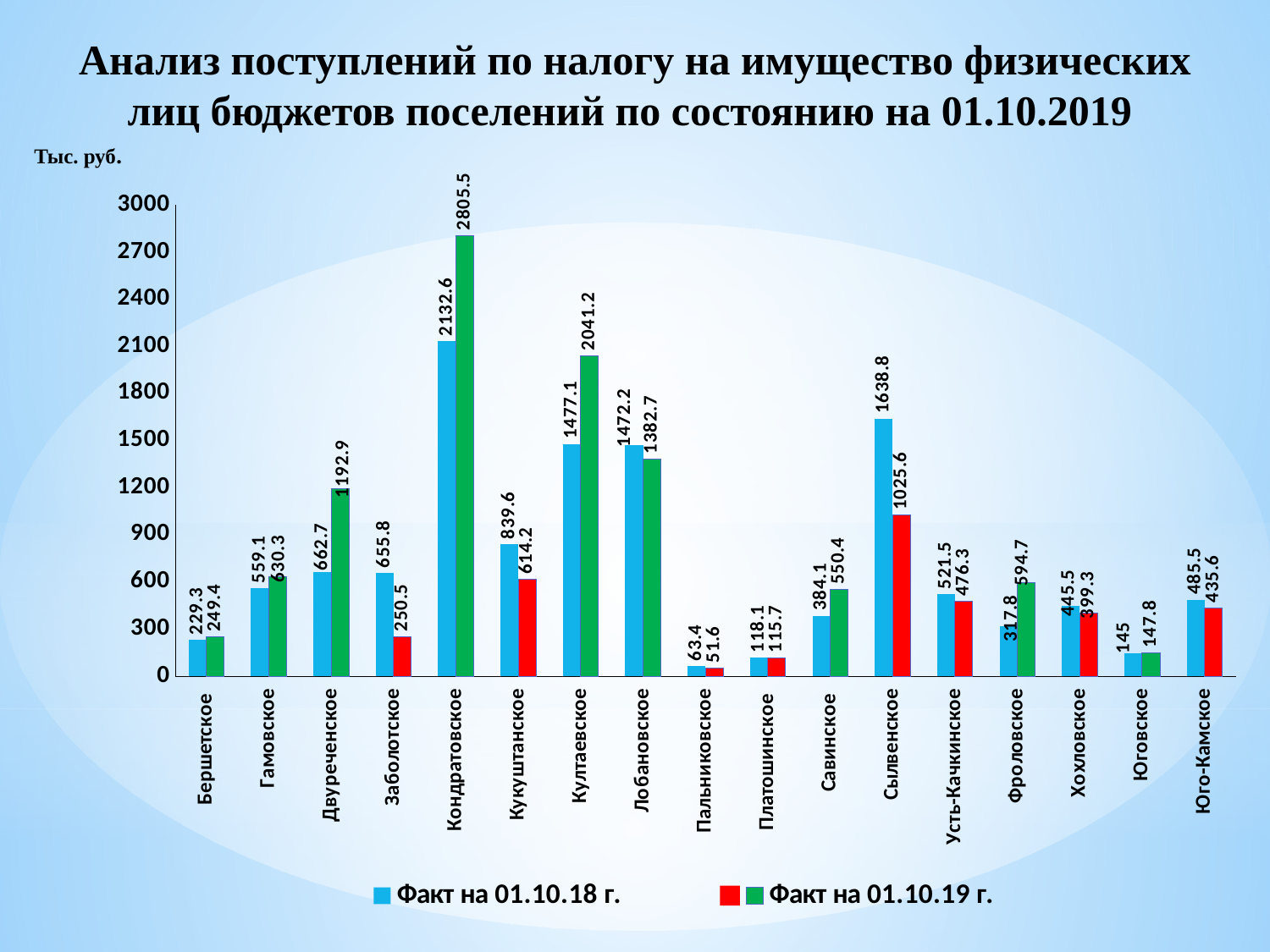
What is the value for Кондратовское in the series Факт на 01.10.19 г.? 2805.5 Which category has the lowest value in the series Факт на 01.10.18 г.? Пальниковское What is the difference between the Факт на 01.10.19 г. and Факт на 01.10.18 г. values for Кондратовское? 672.9 How many categories (settlements) are shown on the x axis? 17 Which is larger: the Факт на 01.10.18 г. value for Кукуштанское or the Факт на 01.10.18 г. value for Гамовское? Кукуштанское What is the value for Фроловское in the series Факт на 01.10.19 г.? 594.7 What is the value for Сылвенское in the series Факт на 01.10.18 г.? 1638.8 For Двуреченское, which series has the larger value: Факт на 01.10.18 г. or Факт на 01.10.19 г.? Факт на 01.10.19 г. What is the difference between the Факт на 01.10.18 г. and Факт на 01.10.19 г. values for Заболотское? 405.3 Which category has the highest value in the series Факт на 01.10.19 г.? Кондратовское How many series does the legend list? 2 What kind of chart is shown on the slide? Bar chart